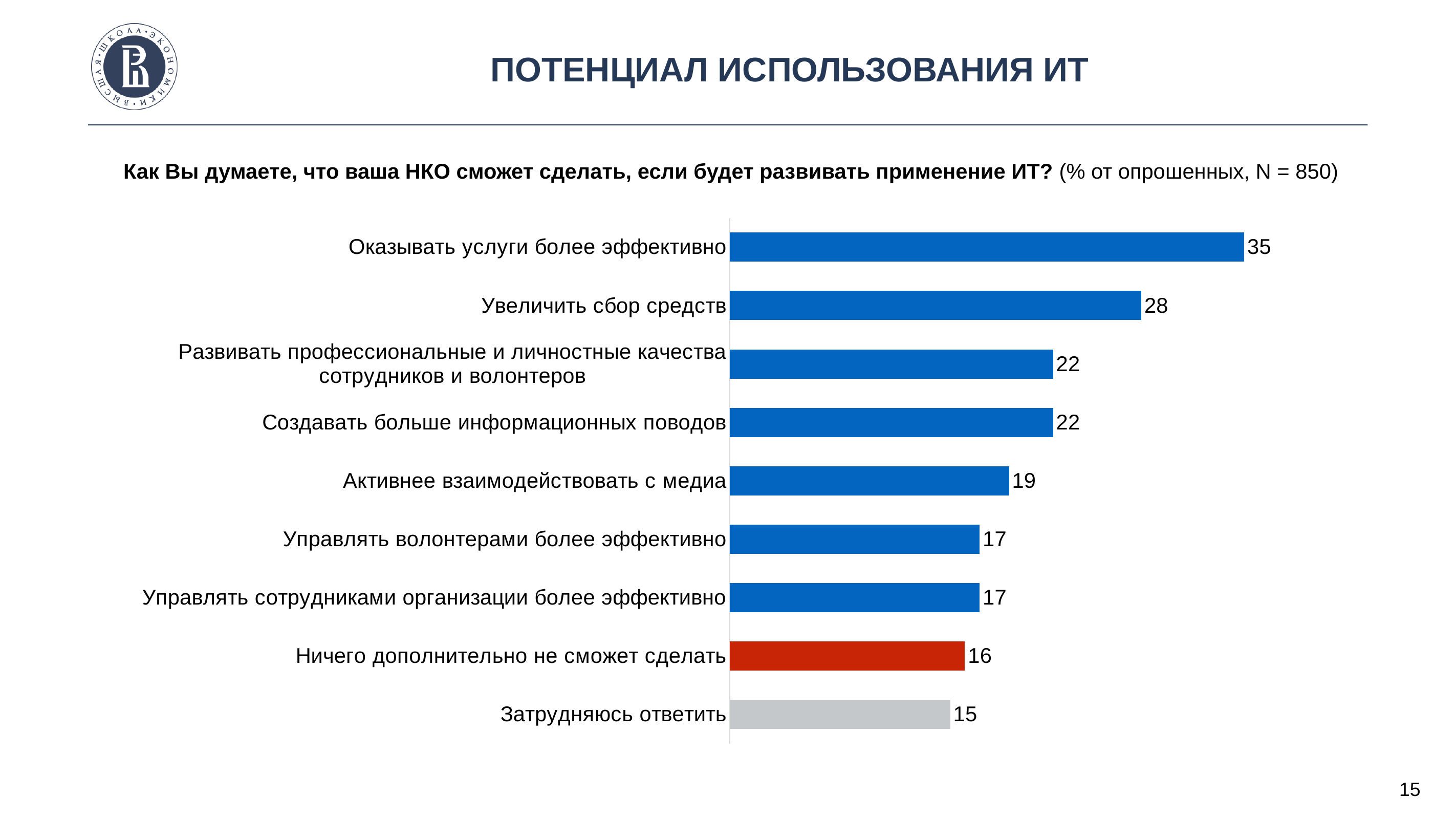
How many categories are shown in the chart? 9 What is the value for "Ничего дополнительно не сможет сделать"? 16 Which category has the highest value? Оказывать услуги более эффективно Which category's bar is coloured red? Ничего дополнительно не сможет сделать What kind of chart is shown on the slide? Bar chart Which is larger: the value for "Увеличить сбор средств" or the value for "Создавать больше информационных поводов"? Увеличить сбор средств Which category has the lowest value? Затрудняюсь ответить What is the value for "Затрудняюсь ответить"? 15 What is the value for "Оказывать услуги более эффективно"? 35 What is the value for "Увеличить сбор средств"? 28 What is the value for "Активнее взаимодействовать с медиа"? 19 What is the difference between the values for "Оказывать услуги более эффективно" and "Увеличить сбор средств"? 7